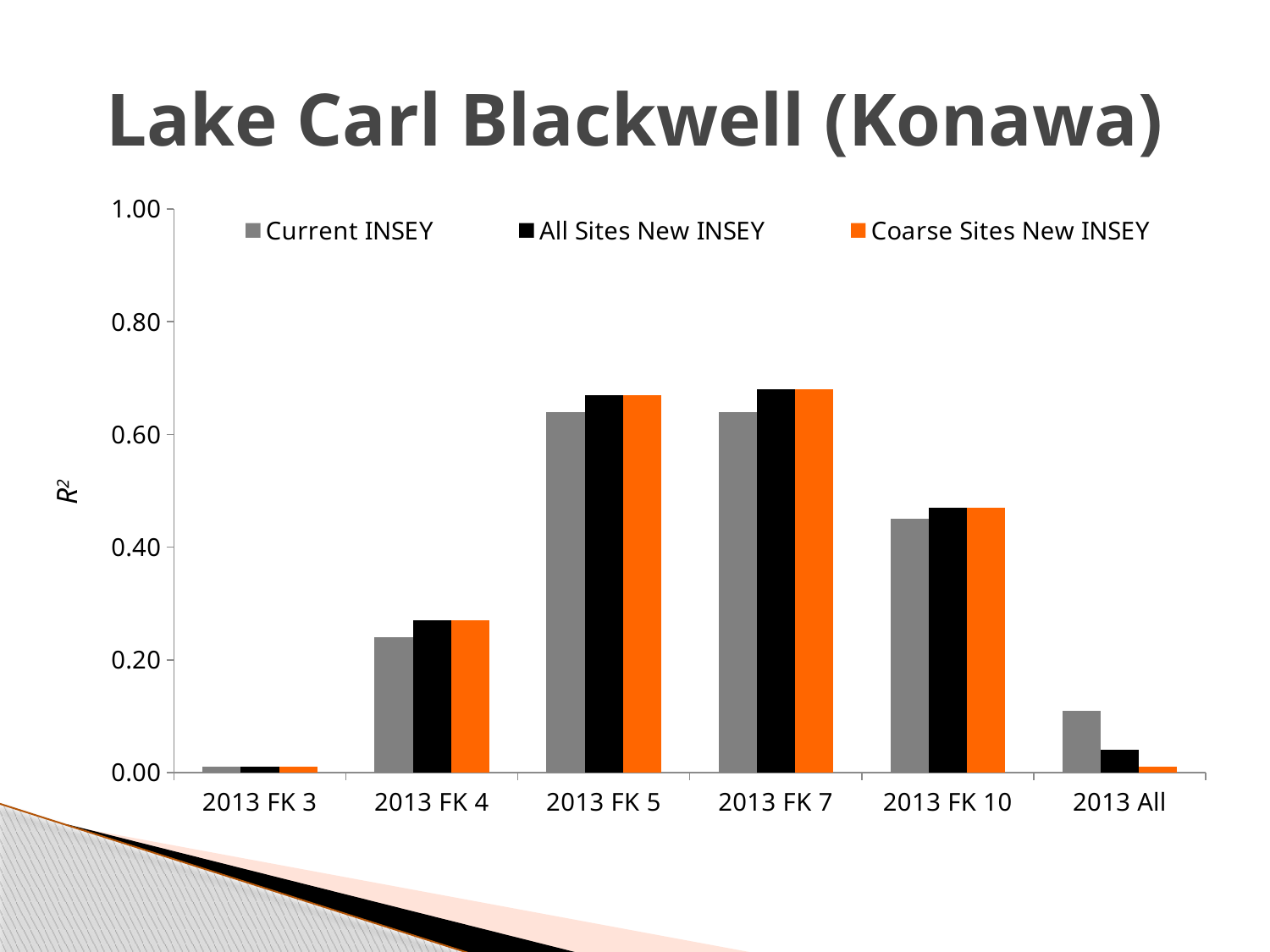
Is the All Sites New INSEY value for 2013 FK 7 greater or less than 0.80? less Is the Coarse Sites New INSEY value for 2013 FK 4 greater or less than 0.20? greater For 2013 All, which is larger: Current INSEY or All Sites New INSEY? Current INSEY Is the Current INSEY value for 2013 FK 5 greater or less than 0.60? greater What is the label on the y axis? R² Which category has the lowest Current INSEY value? 2013 FK 3 How many categories are shown on the x axis? 6 What kind of chart is shown on the slide? bar chart How many series does the legend list? 3 For Current INSEY, which is larger: 2013 FK 5 or 2013 FK 10? 2013 FK 5